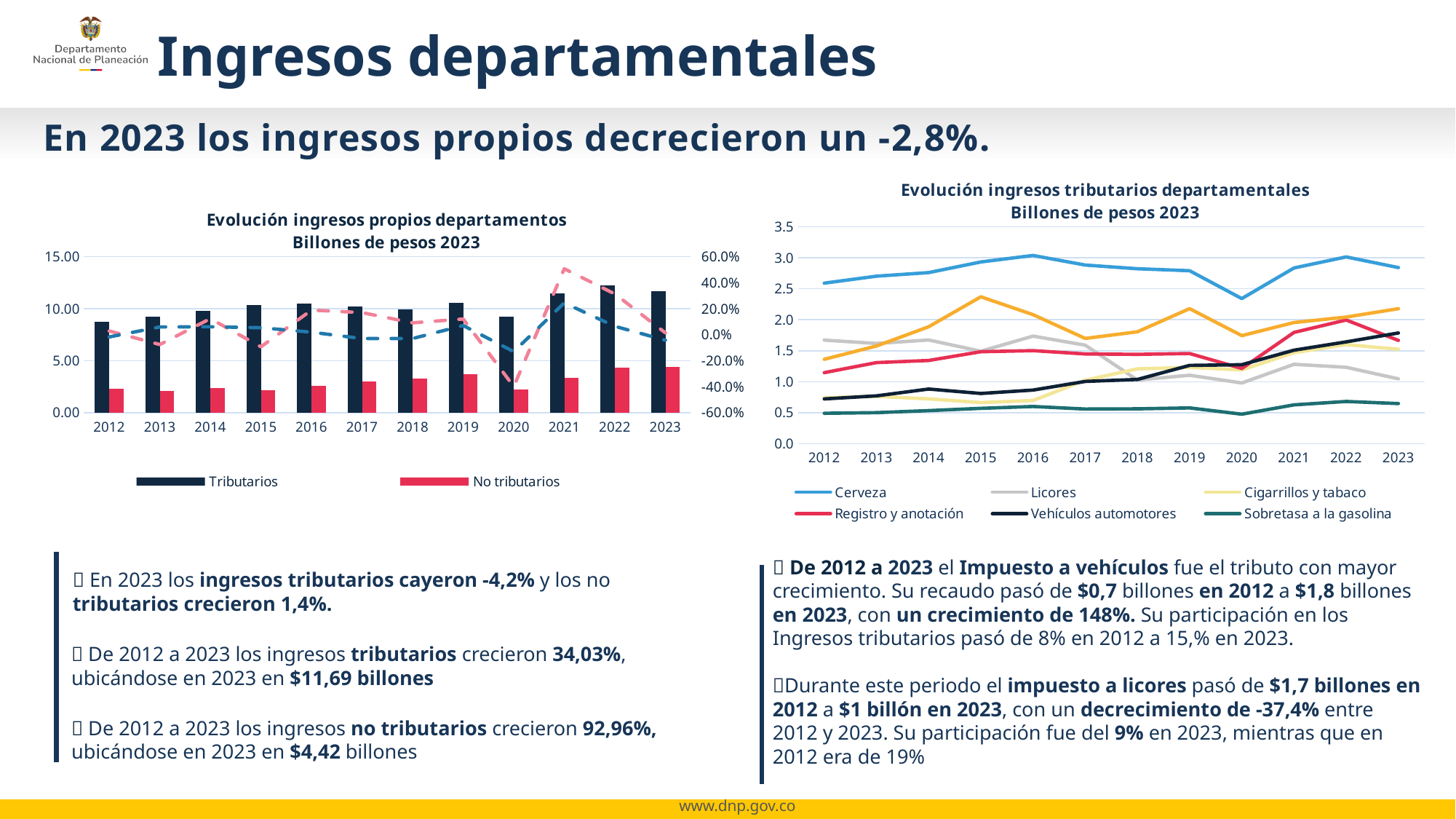
In the right chart 'Evolución ingresos tributarios departamentales', which series has the lowest value in 2023? Sobretasa a la gasolina In the right chart 'Evolución ingresos tributarios departamentales', which series has the highest value in 2023? Cerveza In the right chart 'Evolución ingresos tributarios departamentales', does the Licores line rise or fall from 2012 to 2023? Fall What kind of chart is the left chart titled 'Evolución ingresos propios departamentos'? Combination bar and line chart In the left chart 'Evolución ingresos propios departamentos', which is larger in 2021, the Tributarios bar or the No tributarios bar? Tributarios In the left chart 'Evolución ingresos propios departamentos', how many series does the legend list? 2 In the left chart 'Evolución ingresos propios departamentos', is the Tributarios bar for 2023 greater or less than 10.00? greater What kind of chart is the right chart titled 'Evolución ingresos tributarios departamentales'? Line chart In the right chart 'Evolución ingresos tributarios departamentales', is the value for Cerveza in 2020 greater or less than 2.5? less In the right chart 'Evolución ingresos tributarios departamentales', how many series does the legend list? 6 In the right chart 'Evolución ingresos tributarios departamentales', how many years are shown on the x axis? 12 In the right chart 'Evolución ingresos tributarios departamentales', does the Vehículos automotores line rise or fall from 2012 to 2023? Rise